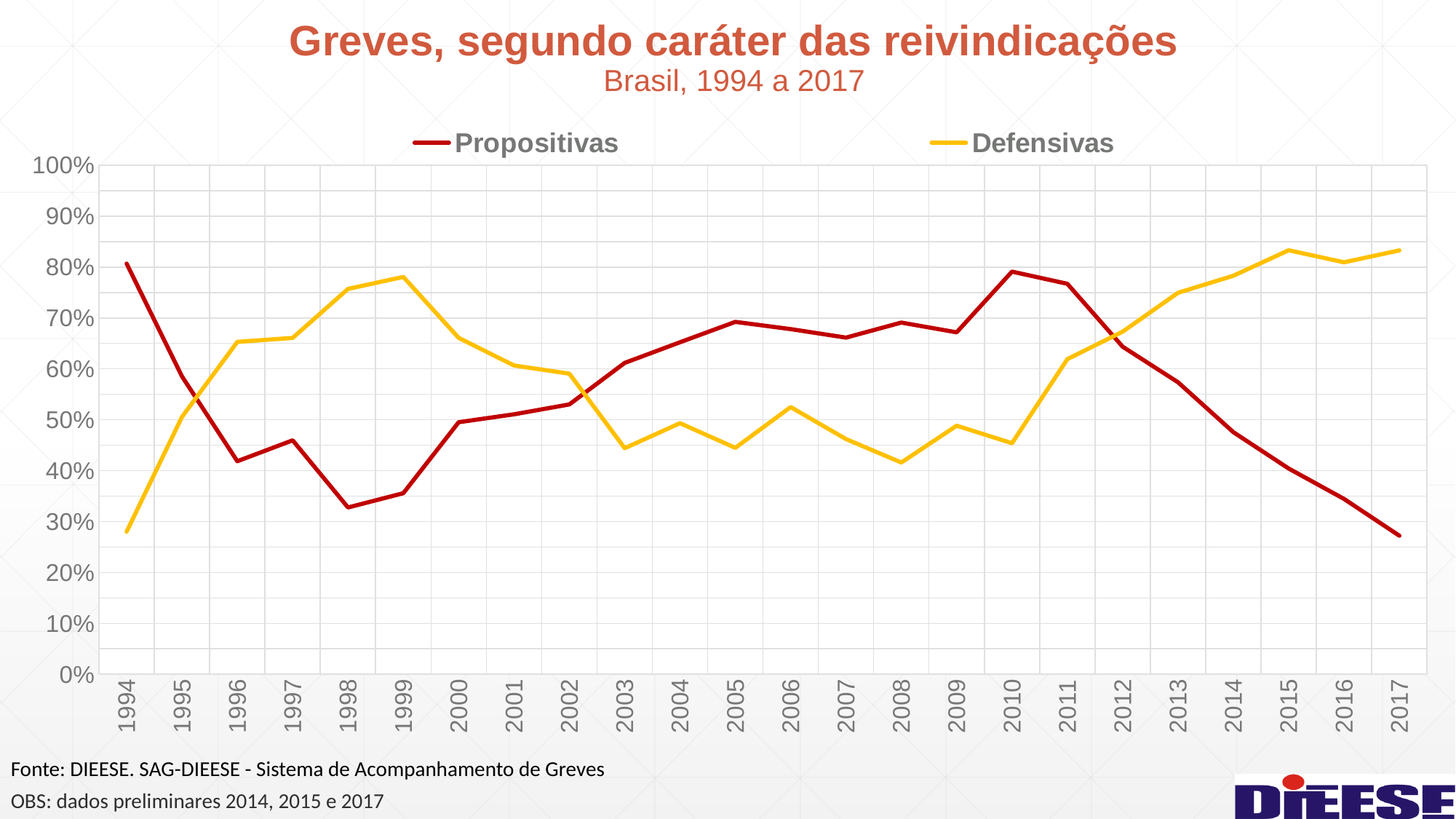
Is the value for Defensivas in 1994 greater or less than 30%? less Is the value for Propositivas in 2010 greater or less than 70%? greater What kind of chart is shown on the slide? line chart What is the subtitle shown under the chart title? Brasil, 1994 a 2017 How many years are plotted along the x axis? 24 In 2017, which series has the larger value, Propositivas or Defensivas? Defensivas Is the value for Defensivas in 1999 greater or less than 70%? greater Which series is drawn in yellow? Defensivas How many series does the legend list? 2 In which year is the Defensivas series at its lowest? 1994 Does the Propositivas series rise or fall from 2010 to 2017? fall